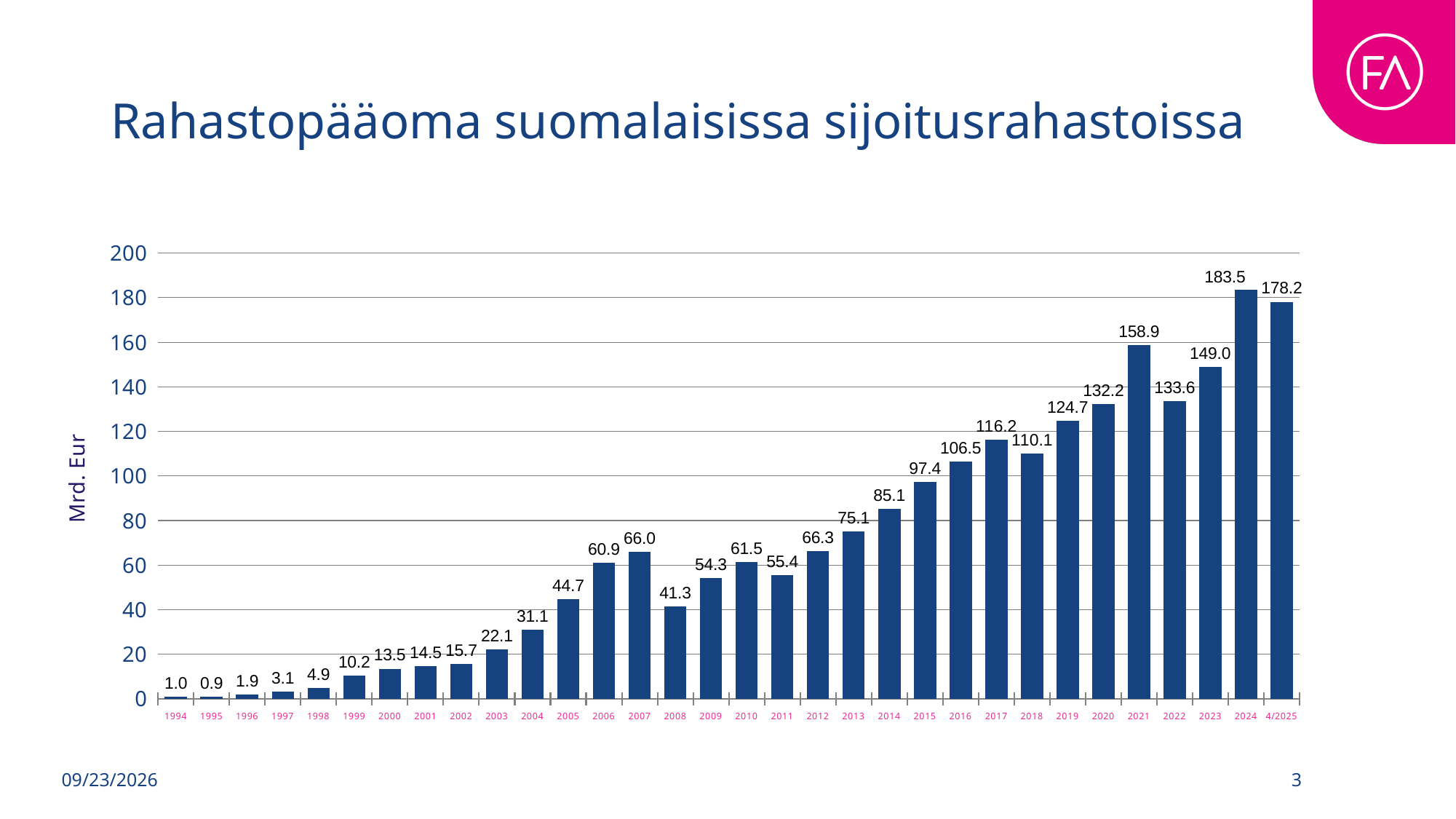
What is the value for 2008? 41.3 What is the value for 2015? 97.4 Which year has the highest value? 2024 How many bars are shown in the chart? 32 Which year has the lowest value? 1995 What is the difference between the values for 2021 and 2022? 25.3 What is the value for 4/2025? 178.2 What kind of chart is shown on the slide? bar chart What is the label of the vertical axis? Mrd. Eur What is the value for 2024? 183.5 What is the difference between the values for 2024 and 4/2025? 5.3 Which is larger, the value for 2007 or the value for 2012? 2012